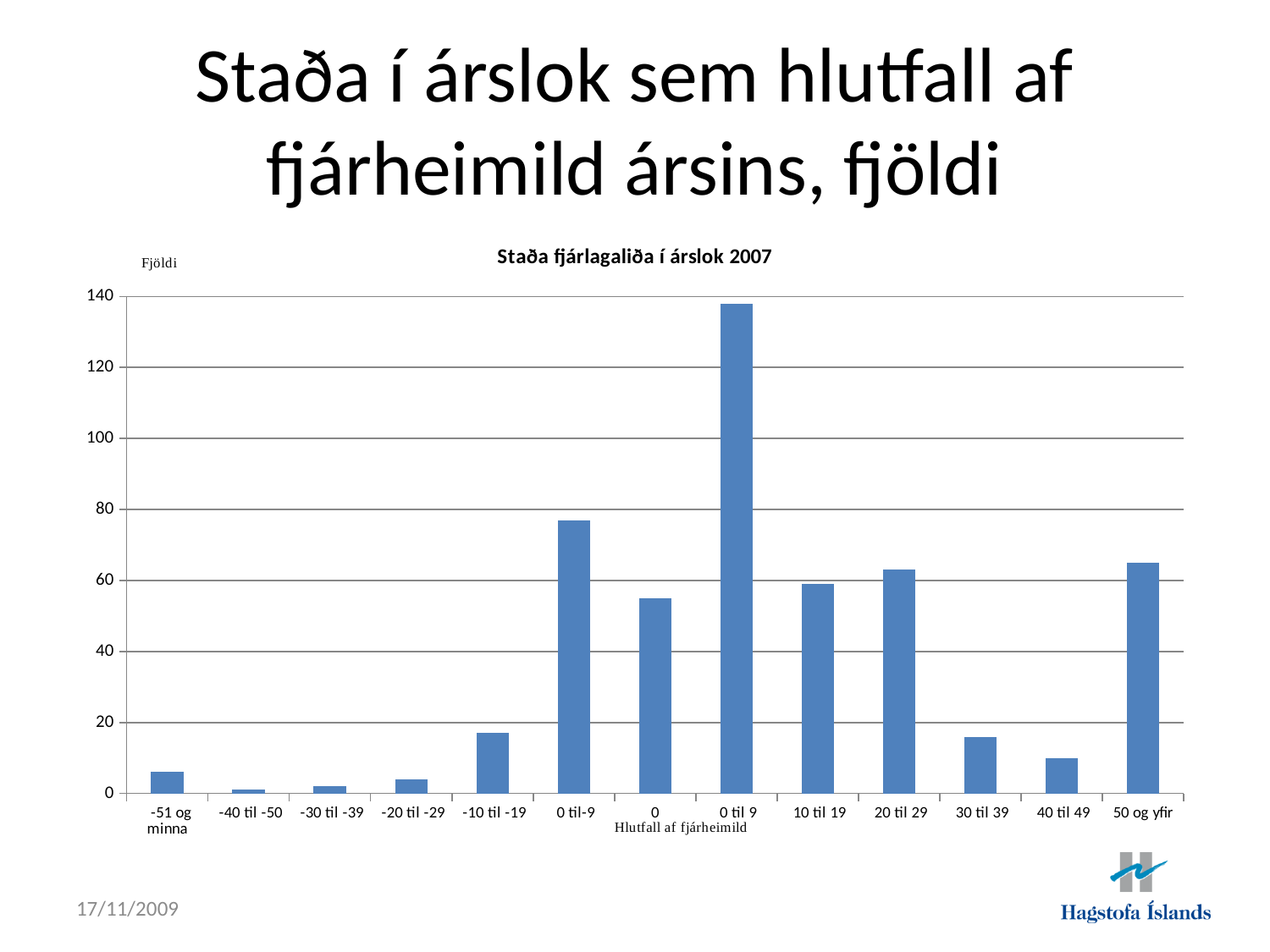
Which category has the highest value? 0 til 9 What kind of chart is shown on the slide? bar chart Is the value for -10 til -19 greater or less than 20? less What is the title of the chart? Staða fjárlagaliða í árslok 2007 Which is larger, the value for 0 til-9 or the value for 0? 0 til-9 Is the value for 30 til 39 greater or less than 20? less What is the label of the x axis? Hlutfall af fjárheimild Is the value for 0 greater or less than 40? greater Which is larger, the value for 0 til 9 or the value for 50 og yfir? 0 til 9 How many categories are shown on the x axis? 13